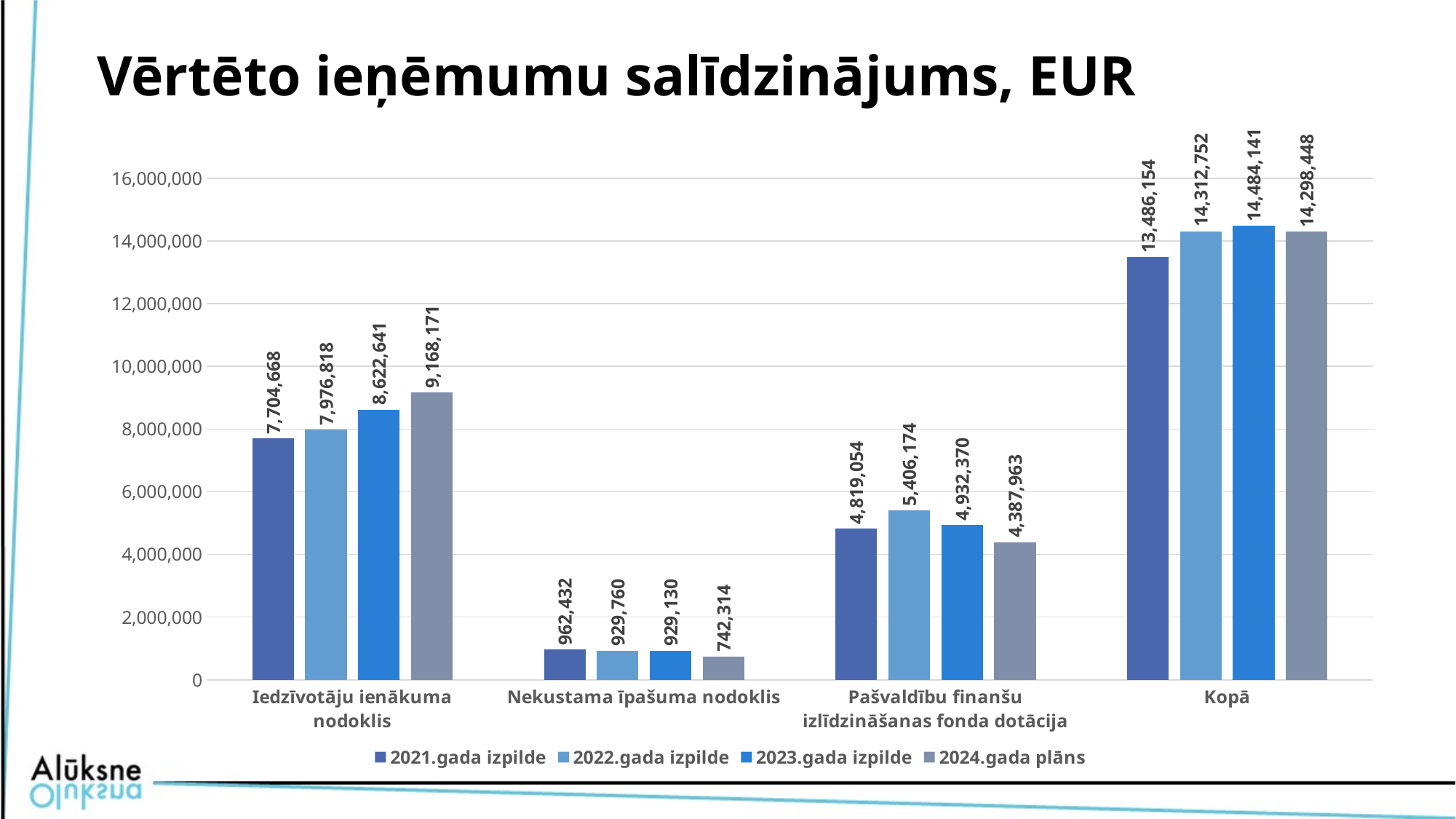
How many categories are shown on the x axis? 4 How many series does the legend list? 4 What is the value for Kopā in the 2021.gada izpilde series? 13,486,154 What is the value for Nekustama īpašuma nodoklis in the 2022.gada izpilde series? 929,760 What kind of chart is shown on the slide? bar chart What is the value for Iedzīvotāju ienākuma nodoklis in the 2024.gada plāns series? 9,168,171 Which series has the highest value for Kopā? 2023.gada izpilde Is the 2024.gada plāns value for Pašvaldību finanšu izlīdzināšanas fonda dotācija greater or less than 6,000,000? less What is the difference between the 2024.gada plāns and 2021.gada izpilde values for Iedzīvotāju ienākuma nodoklis? 1,463,503 Which series has the lowest value for Nekustama īpašuma nodoklis? 2024.gada plāns Which is larger for Pašvaldību finanšu izlīdzināšanas fonda dotācija: the 2022.gada izpilde value or the 2023.gada izpilde value? 2022.gada izpilde What is the value for Pašvaldību finanšu izlīdzināšanas fonda dotācija in the 2023.gada izpilde series? 4,932,370